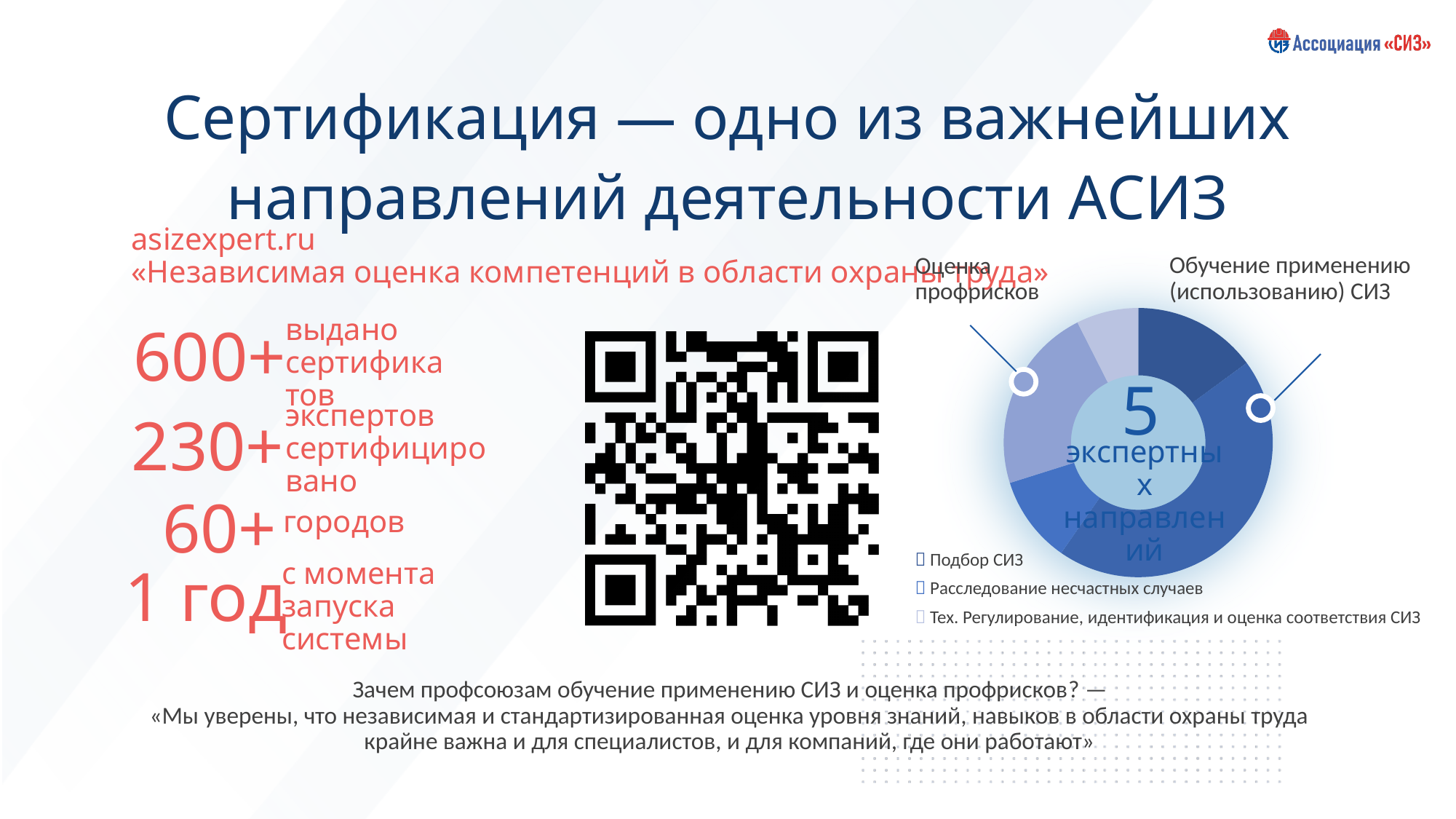
How many segments does the doughnut chart have? 5 Which segment of the doughnut chart is labelled with a callout on the left side of the chart? Оценка профрисков What text is written in the centre of the doughnut chart? 5 экспертных направлений What number is printed in the centre of the doughnut chart? 5 What kind of chart is shown on the right side of the slide? doughnut chart